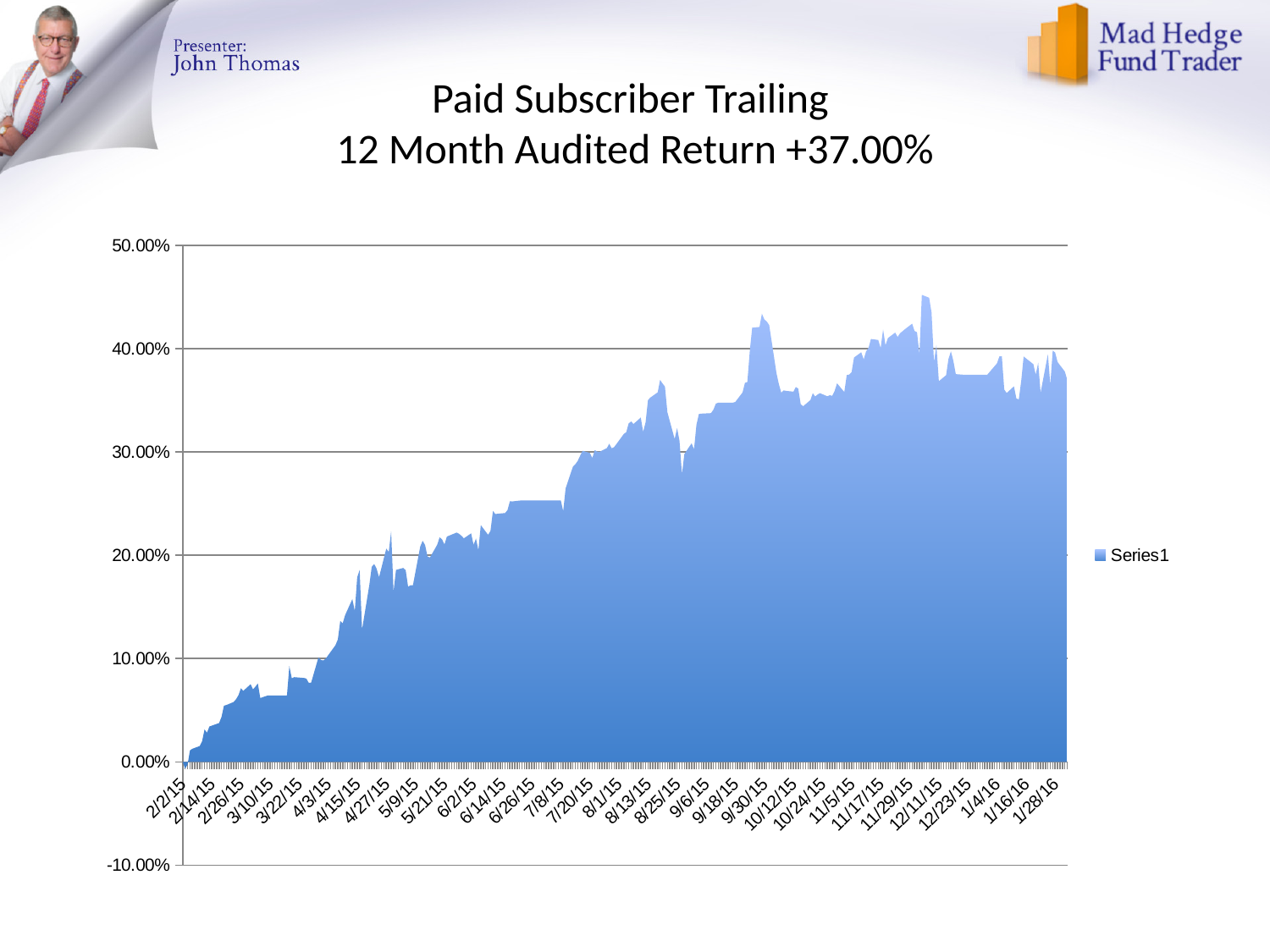
Is the value for 3/10/15 greater or less than 10.00%? less Is the value for 10/24/15 greater or less than 30.00%? greater What is the title of the chart on the slide? Paid Subscriber Trailing 12 Month Audited Return +37.00% What is the name of the series shown in the legend? Series1 Overall, do the values rise or fall from 2/2/15 to 1/28/16? Rise Is the value for 6/26/15 greater or less than 20.00%? greater How many series does the legend list? 1 Which date has the larger value, 3/22/15 or 6/26/15? 6/26/15 What kind of chart is shown on the slide? Area chart Which date has the larger value, 2/2/15 or 1/28/16? 1/28/16